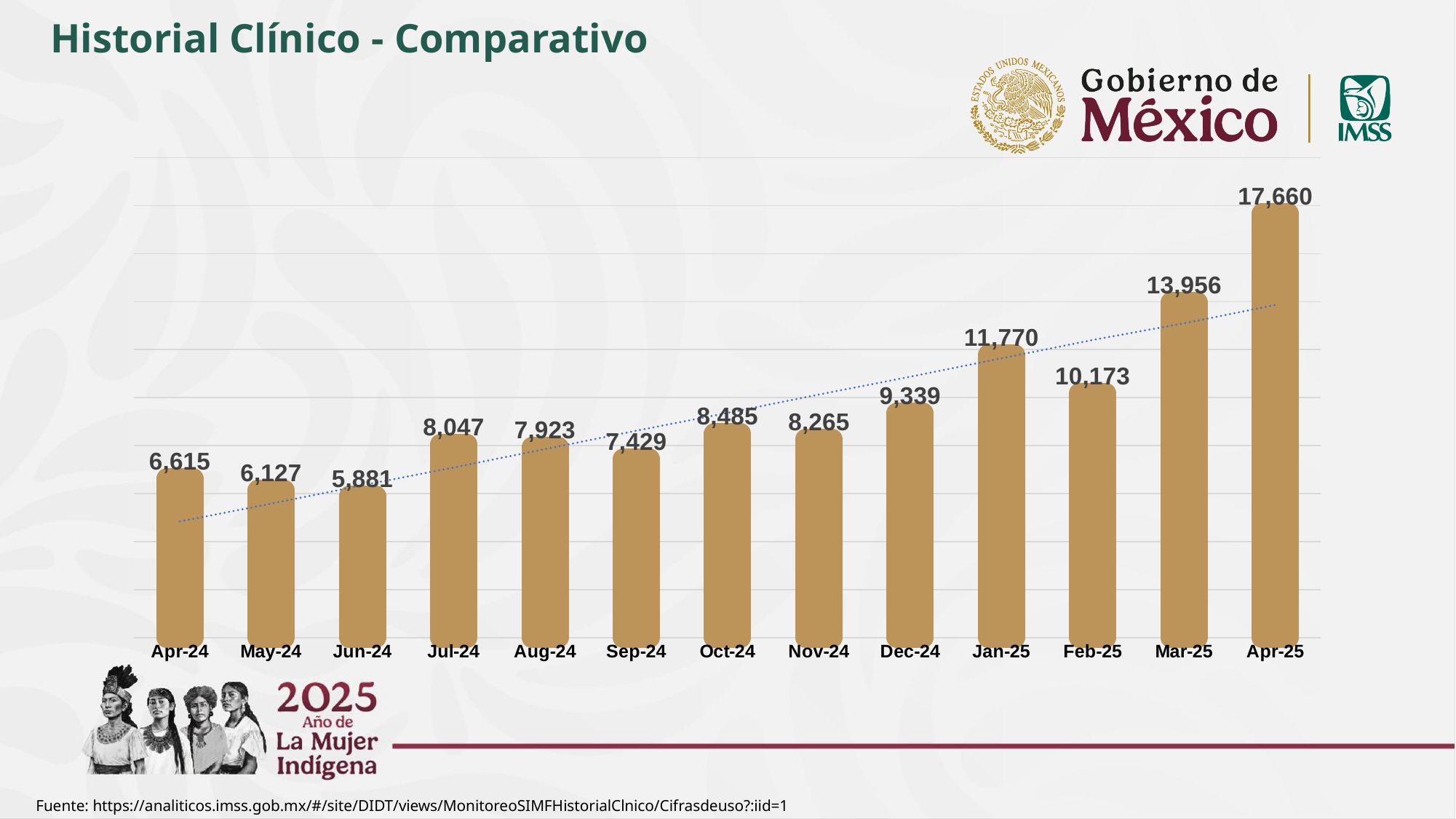
What is the title of the slide? Historial Clínico - Comparativo What is the difference between the values for Jul-24 and Jun-24? 2,166 Which is larger, the value for Oct-24 or the value for Nov-24? Oct-24 Which month has the lowest value? Jun-24 What is the value for Apr-25? 17,660 How many months are shown on the x axis? 13 What is the value for Dec-24? 9,339 What is the value for Jun-24? 5,881 Which is larger, the value for Jan-25 or the value for Feb-25? Jan-25 What kind of chart is shown on the slide? Bar chart Which month has the highest value? Apr-25 What is the difference between the values for Apr-25 and Mar-25? 3,704